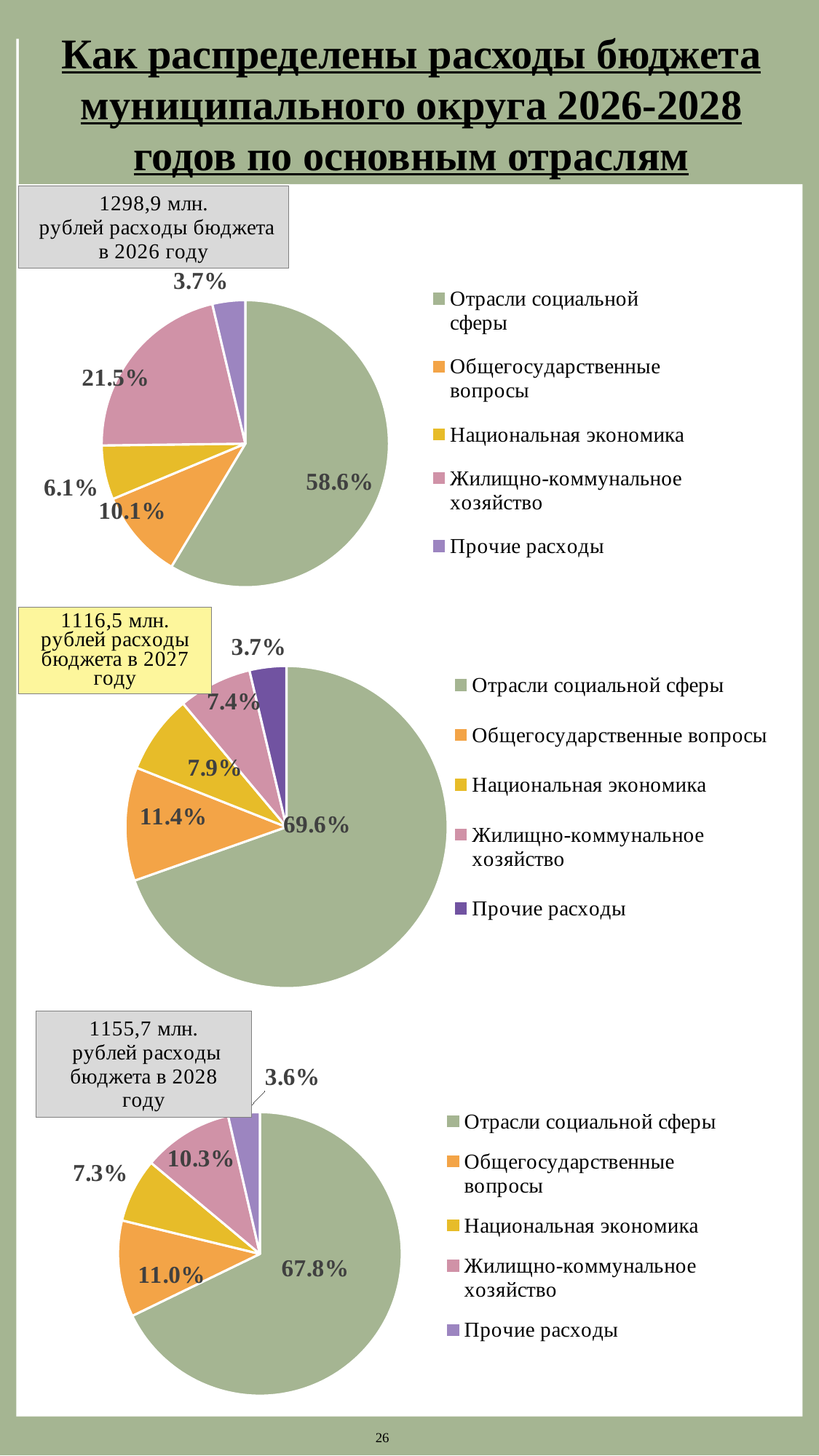
In the 2027 pie chart, which category has the largest share? Отрасли социальной сферы In the 2028 pie chart, what share is shown for Национальная экономика? 7.3% According to the label box above the 2027 pie chart, what is the total budget expenditure in 2027? 1116,5 млн. рублей In the 2026 pie chart, what share is shown for Отрасли социальной сферы? 58.6% In the 2026 pie chart, what share is shown for Жилищно-коммунальное хозяйство? 21.5% In the 2026 pie chart, what is the difference between the shares of Общегосударственные вопросы and Национальная экономика? 4.0% In the 2027 pie chart, what share is shown for Общегосударственные вопросы? 11.4% How many pie charts are shown on the slide? 3 How many categories does the legend of the 2027 pie chart list? 5 In the 2028 pie chart, which is larger: the share of Жилищно-коммунальное хозяйство or the share of Национальная экономика? Жилищно-коммунальное хозяйство In the 2028 pie chart, which category has the smallest share? Прочие расходы What type of chart is used to show the 2026 budget expenditures? Pie chart